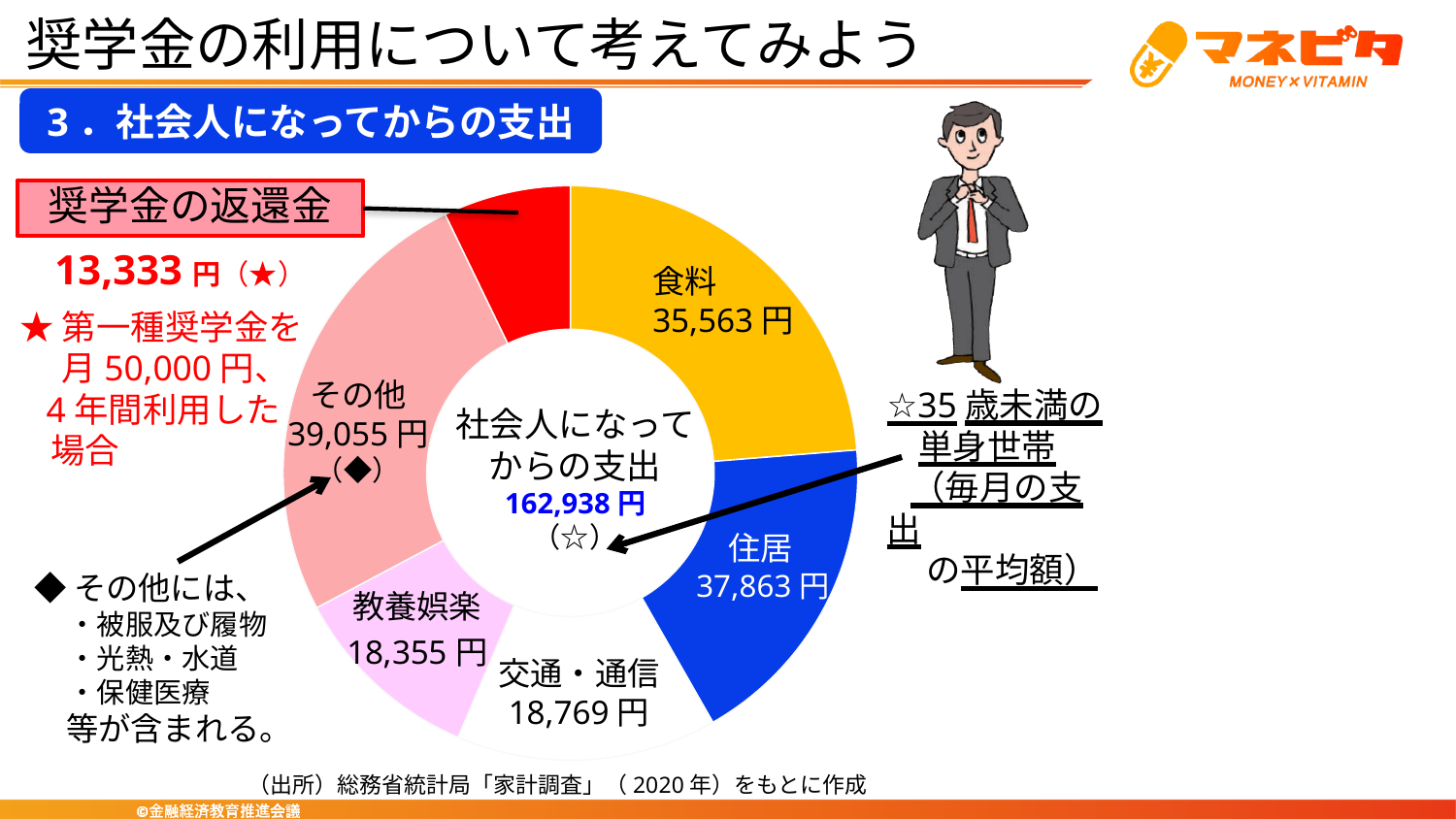
How many categories are shown in the donut chart? 6 Which category has the largest value in the donut chart? その他 (39,055 円) Which is larger in the donut chart, 交通・通信 or 教養娯楽? 交通・通信 What kind of chart is shown on the slide? Donut (pie) chart What is the value for 食料 (food) in the donut chart? 35,563 円 Which category has the smallest value in the donut chart? 奨学金の返還金 (13,333 円) What is the value for 教養娯楽 in the donut chart? 18,355 円 What is the title shown in the centre of the donut chart? 社会人になってからの支出 What is the value for 奨学金の返還金 (scholarship repayment) in the donut chart? 13,333 円 What is the total monthly expenditure shown in the centre of the donut chart? 162,938 円 What is the difference between 住居 and 食料 in the donut chart? 2,300 円 What is the value for 住居 (housing) in the donut chart? 37,863 円